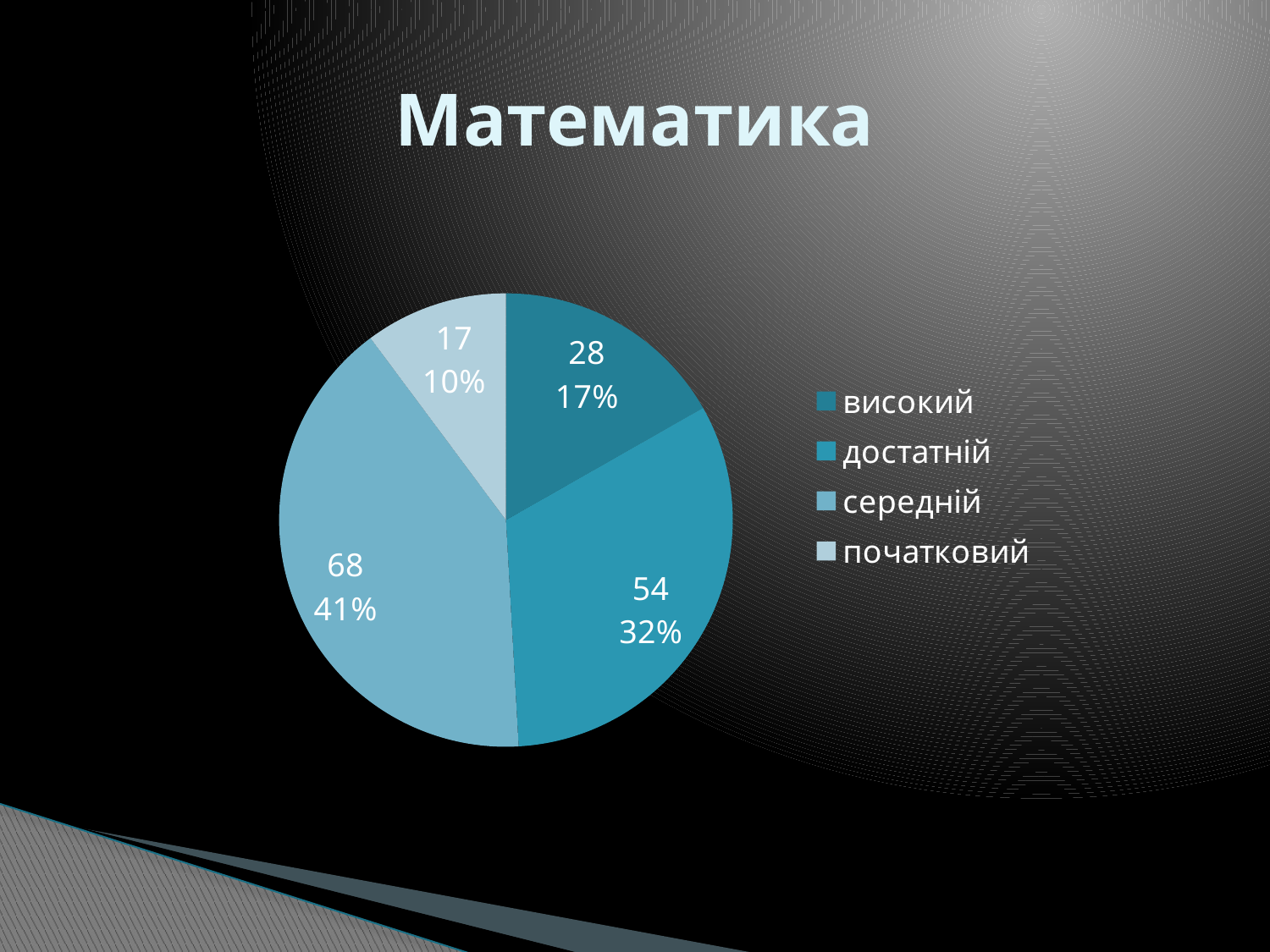
What is the value for достатній? 54 How many categories does the legend list? 4 Which category has the largest slice? середній What kind of chart is shown on the slide? pie chart Which is larger, the value for високий or the value for достатній? достатній What is the value for початковий? 17 What is the difference between the values for середній and достатній? 14 What share of the pie does початковий take? 10% What share of the pie does середній take? 41% What is the value for високий? 28 What is the value for середній? 68 Which category has the smallest slice? початковий